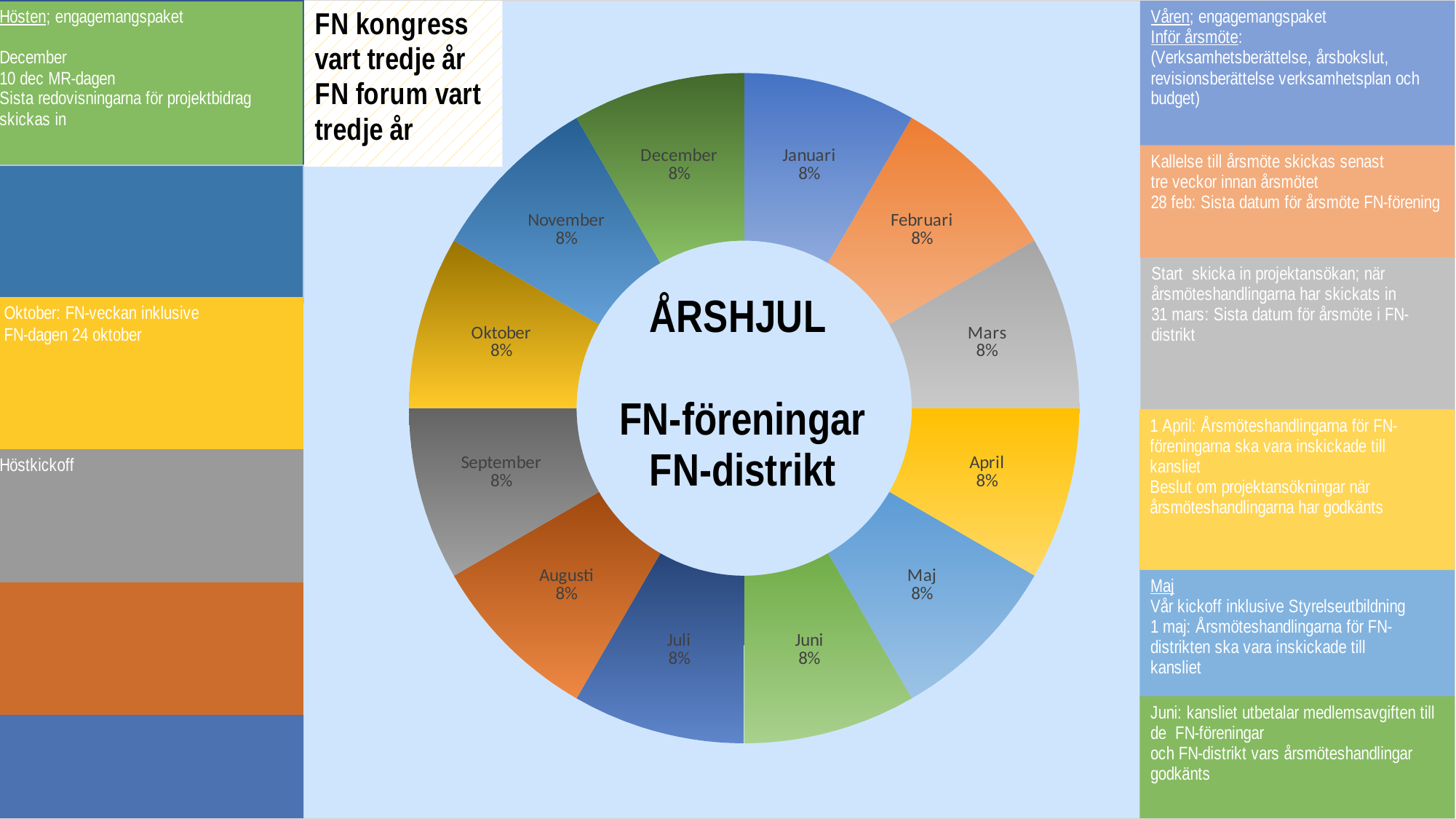
What share of the chart does the Mars segment represent? 8% What colour is the April segment of the chart? yellow What kind of chart is shown on the slide? doughnut chart What percentage is shown for the September segment? 8% What percentage is shown for the December segment? 8% What share of the chart does the Juni segment represent? 8% What text is written in the centre of the chart? ÅRSHJUL FN-föreningar FN-distrikt What value is labelled on the Juli segment? 8% What percentage is shown for the Januari segment? 8% What percentage is shown for the Maj segment? 8% How many segments does the chart have? 12 What percentage is shown for the Oktober segment? 8%